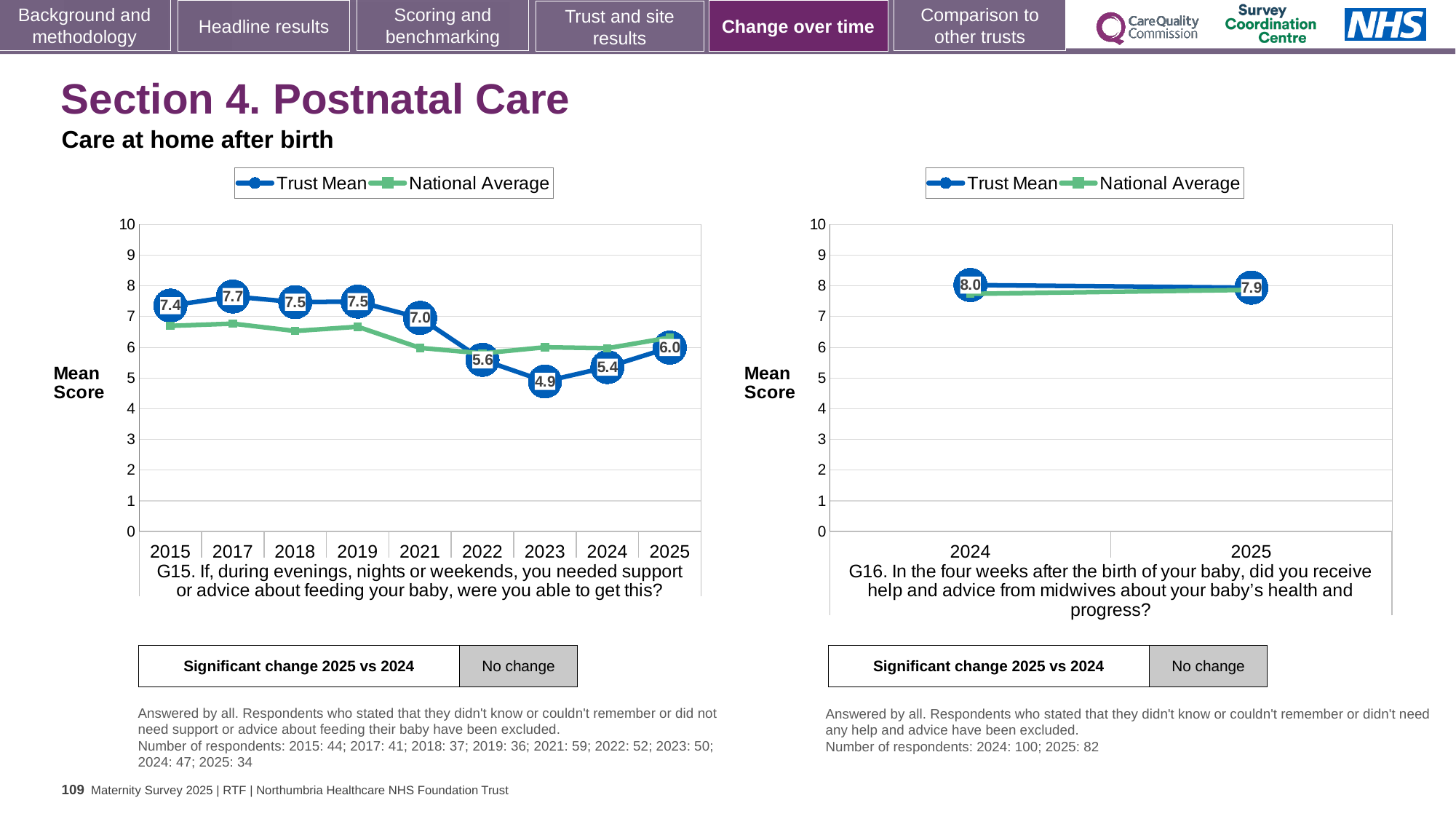
In the G15 chart on the left, which year has the lowest Trust Mean score? 2023 How many years are plotted on the x axis of the G15 chart on the left? 9 In the G15 chart on the left, which year has the highest Trust Mean score? 2017 What type of chart is the G15 chart on the left? Line chart In the G15 chart on the left, what is the Trust Mean score for 2023? 4.9 In the G15 chart on the left, what is the Trust Mean score for 2025? 6.0 In the G15 chart on the left, is the National Average for 2015 greater or less than 6? greater How many series does the legend of the G16 chart on the right list? 2 In the G15 chart on the left, is the Trust Mean score higher in 2021 or in 2022? 2021 In the G15 chart on the left, what is the difference between the Trust Mean scores for 2017 and 2023? 2.8 In the G16 chart on the right, what is the difference between the Trust Mean scores for 2024 and 2025? 0.1 In the G16 chart on the right, what is the Trust Mean score for 2024? 8.0